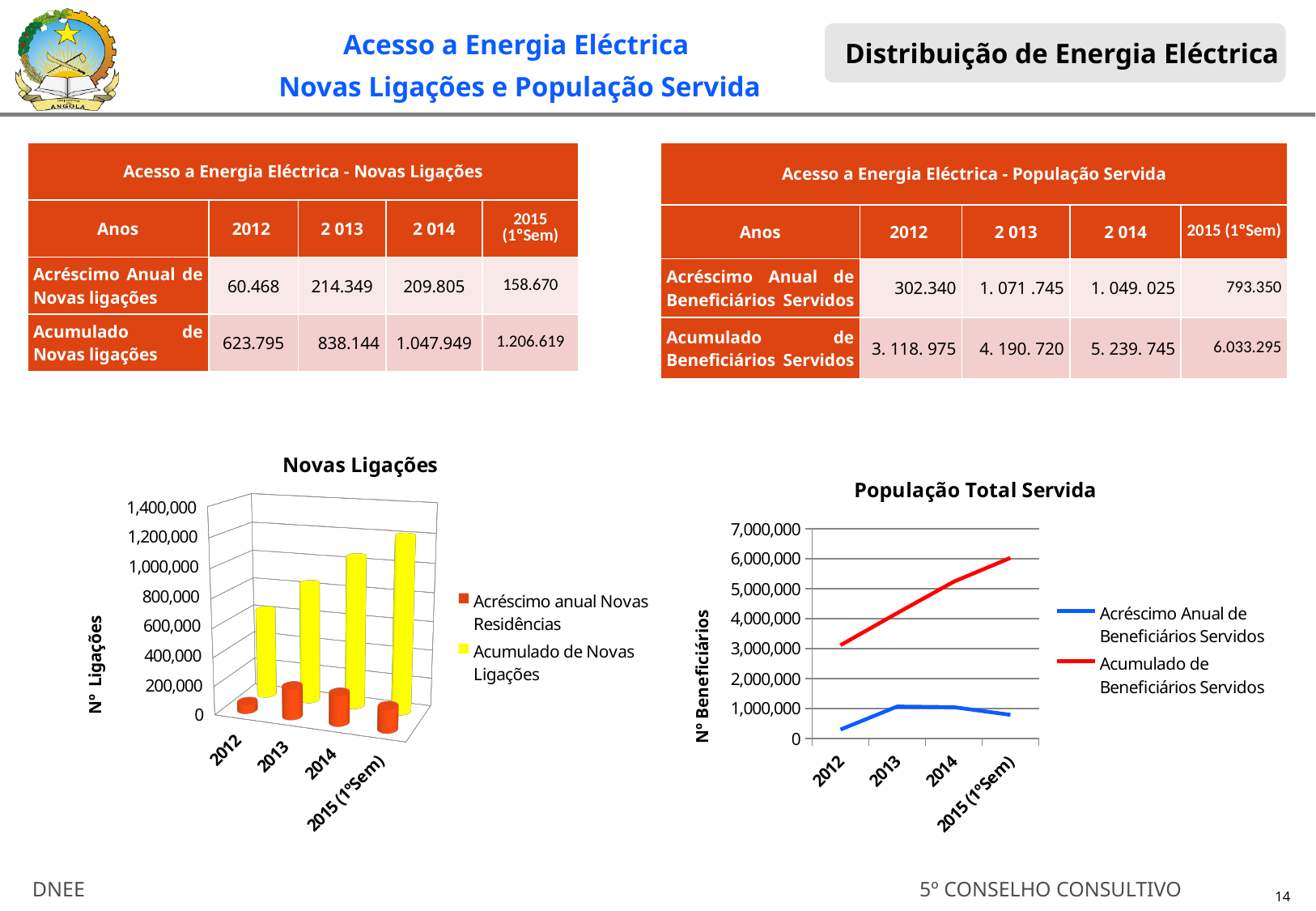
In the "População Total Servida" chart, how many categories are shown on the x axis? 4 In the "População Total Servida" chart, is the value for "Acréscimo Anual de Beneficiários Servidos" in 2012 greater or less than 1,000,000? less In the "Novas Ligações" chart, which year has the lowest value for "Acréscimo anual Novas Residências"? 2012 In the "Novas Ligações" chart, how many series does the legend list? 2 In the "Novas Ligações" chart, is the value for "Acréscimo anual Novas Residências" in 2012 greater or less than 200,000? less In the "População Total Servida" chart, is the value for "Acumulado de Beneficiários Servidos" in 2015 (1ºSem) greater or less than 5,000,000? greater What kind of chart is the "Novas Ligações" chart? bar chart In the "Novas Ligações" chart, which year has the highest value for "Acumulado de Novas Ligações"? 2015 (1ºSem) In the "População Total Servida" chart, which colour is the "Acumulado de Beneficiários Servidos" line? red What kind of chart is the "População Total Servida" chart? line chart In the "População Total Servida" chart, does the "Acumulado de Beneficiários Servidos" line rise or fall from 2012 to 2015 (1ºSem)? rise